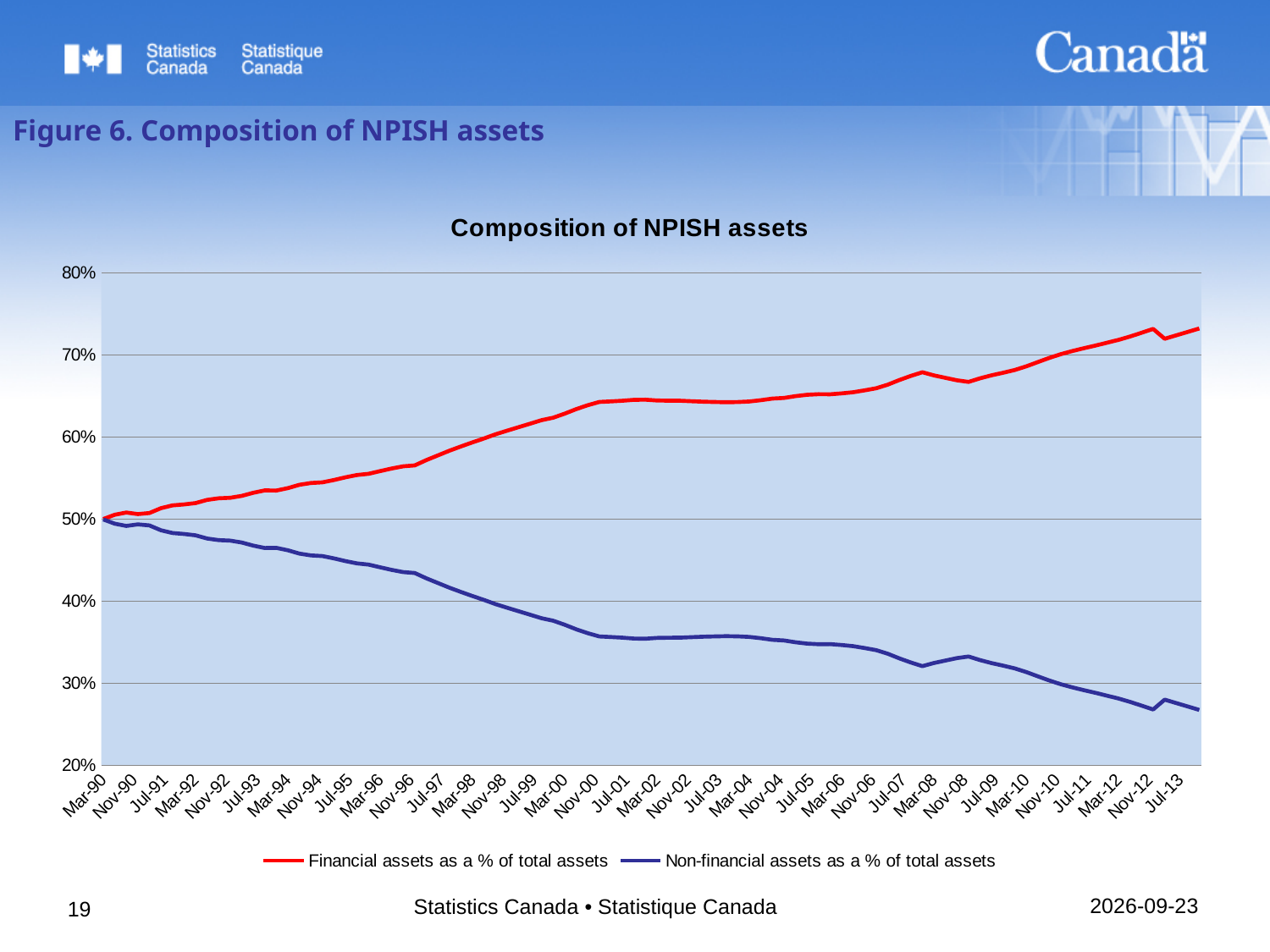
Is the value for Financial assets as a % of total assets at Mar-00 greater or less than 60%? greater Is the value for Financial assets as a % of total assets at Mar-08 greater or less than 70%? less At Jul-13, which series has the higher value: Financial assets as a % of total assets or Non-financial assets as a % of total assets? Financial assets as a % of total assets What colour is the line for Financial assets as a % of total assets? Red Is the value for Non-financial assets as a % of total assets at Mar-00 greater or less than 40%? less Does the line for Financial assets as a % of total assets generally rise or fall from Mar-90 to Jul-13? Rise How many series does the legend list? 2 What kind of chart is shown on the slide? Line chart What is the title of the chart? Composition of NPISH assets Does the line for Non-financial assets as a % of total assets generally rise or fall from Mar-90 to Jul-13? Fall